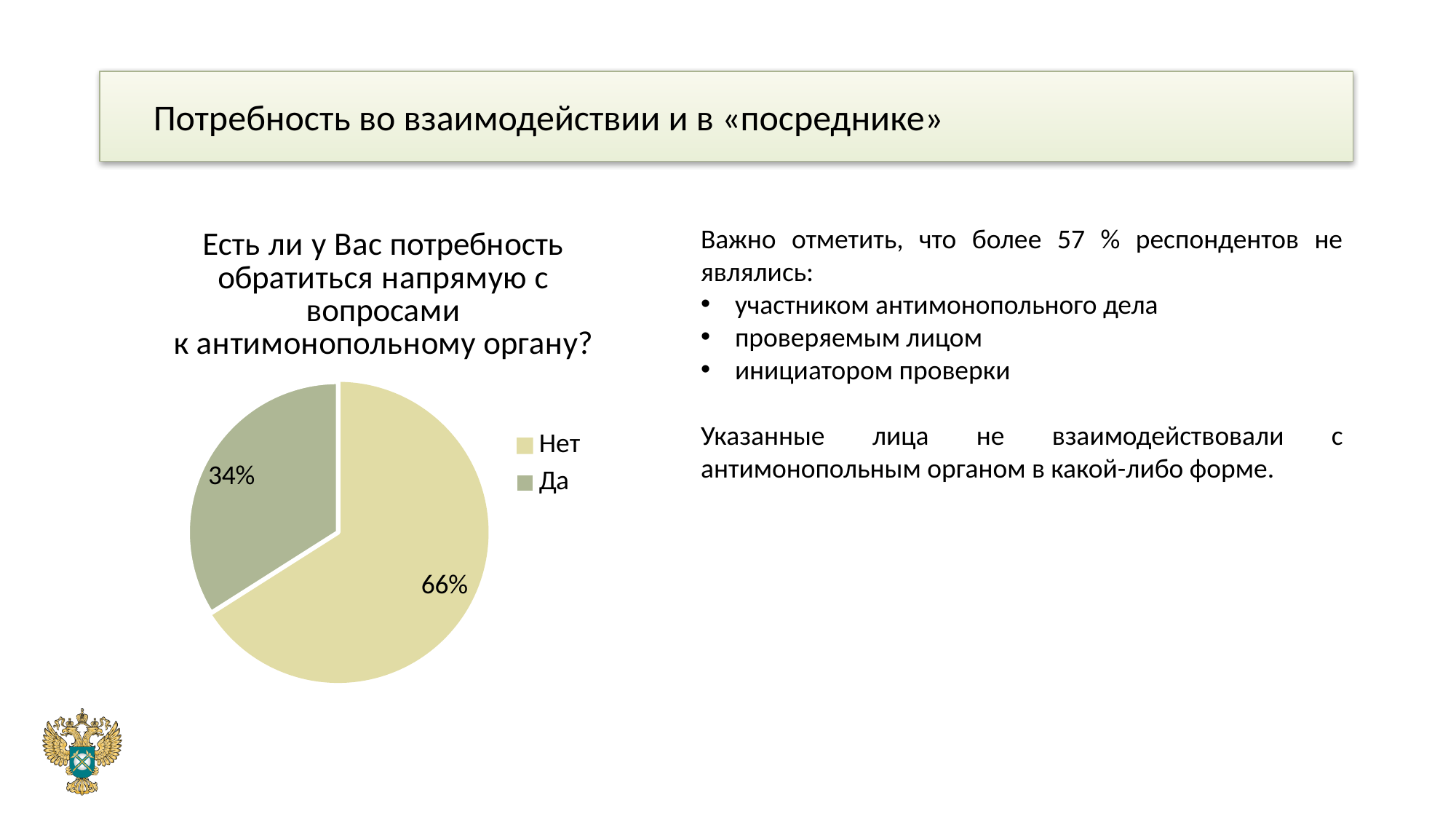
What share of the pie does the "Да" slice represent? 34% How many entries does the legend list? 2 Which is larger, the "Да" slice or the "Нет" slice? Нет How many slices does the pie chart have? 2 What share of the pie does the "Нет" slice represent? 66% What is the title of the pie chart? Есть ли у Вас потребность обратиться напрямую с вопросами к антимонопольному органу? What kind of chart is shown on the slide? pie chart Which legend entry is shown in the darker grey-green colour? Да What is the difference in percentage points between the "Нет" and "Да" slices? 32 Which slice of the pie is the smallest? Да Which slice of the pie is the largest? Нет